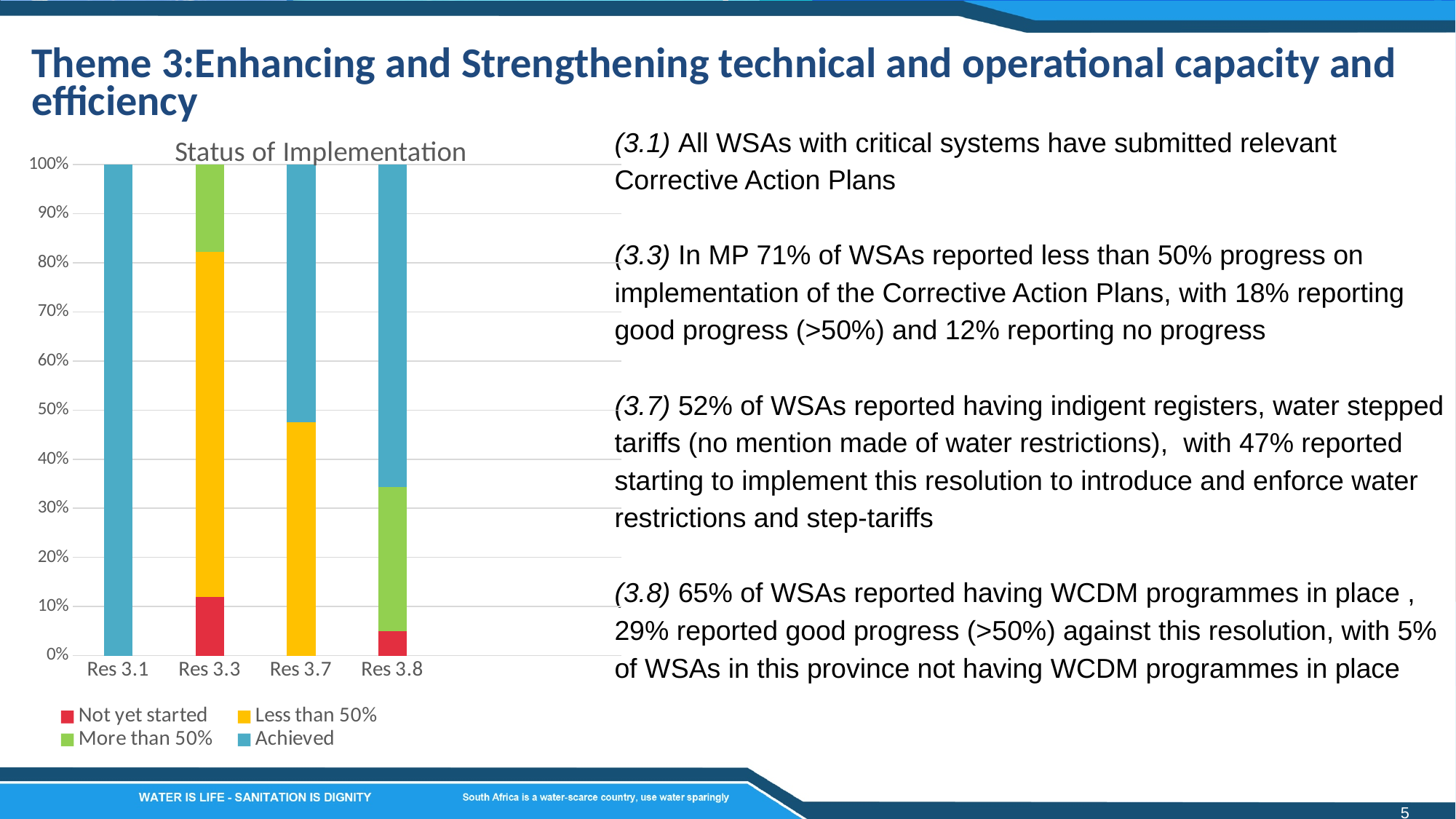
What is the value of the Achieved segment for Res 3.1? 100% What type of chart is shown on the slide? Stacked bar chart Is the Less than 50% segment for Res 3.3 greater or less than 50%? greater Is the Not yet started segment for Res 3.3 greater or less than 20%? less Which category has the largest Achieved segment? Res 3.1 Which category has the smallest Achieved segment? Res 3.3 How many series does the chart legend list? 4 Which colour represents the Achieved series in the chart? Blue Is the Achieved segment for Res 3.8 greater or less than 60%? greater How many categories are shown on the x axis of the chart? 4 What is the title of the chart? Status of Implementation Which is larger: the Less than 50% segment for Res 3.3 or the More than 50% segment for Res 3.8? Less than 50% segment for Res 3.3